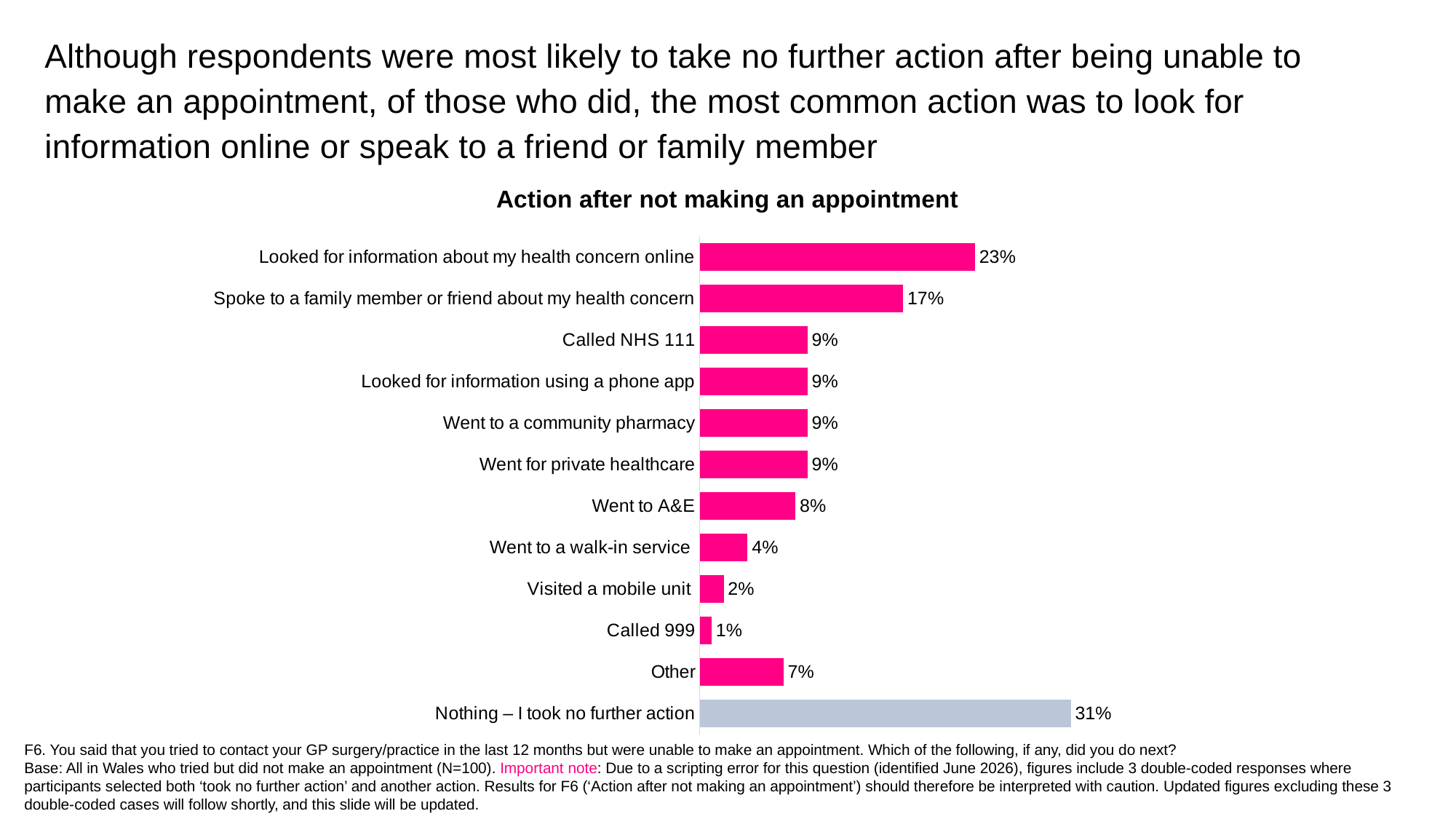
What is the value for 'Went to a walk-in service'? 4% Which bar is shown in a different colour (grey) from the others? Nothing – I took no further action What percentage of respondents looked for information about their health concern online? 23% Which category has the lowest value in the chart? Called 999 What is the difference between 'Looked for information about my health concern online' and 'Spoke to a family member or friend about my health concern'? 6% What kind of chart is shown on the slide? Bar chart Which is larger: 'Went to A&E' or 'Other'? Went to A&E What is the title of the chart? Action after not making an appointment What is the value for 'Nothing – I took no further action'? 31% How many categories are shown in the chart? 12 What percentage of respondents called 999? 1% Which category has the highest value in the chart? Nothing – I took no further action